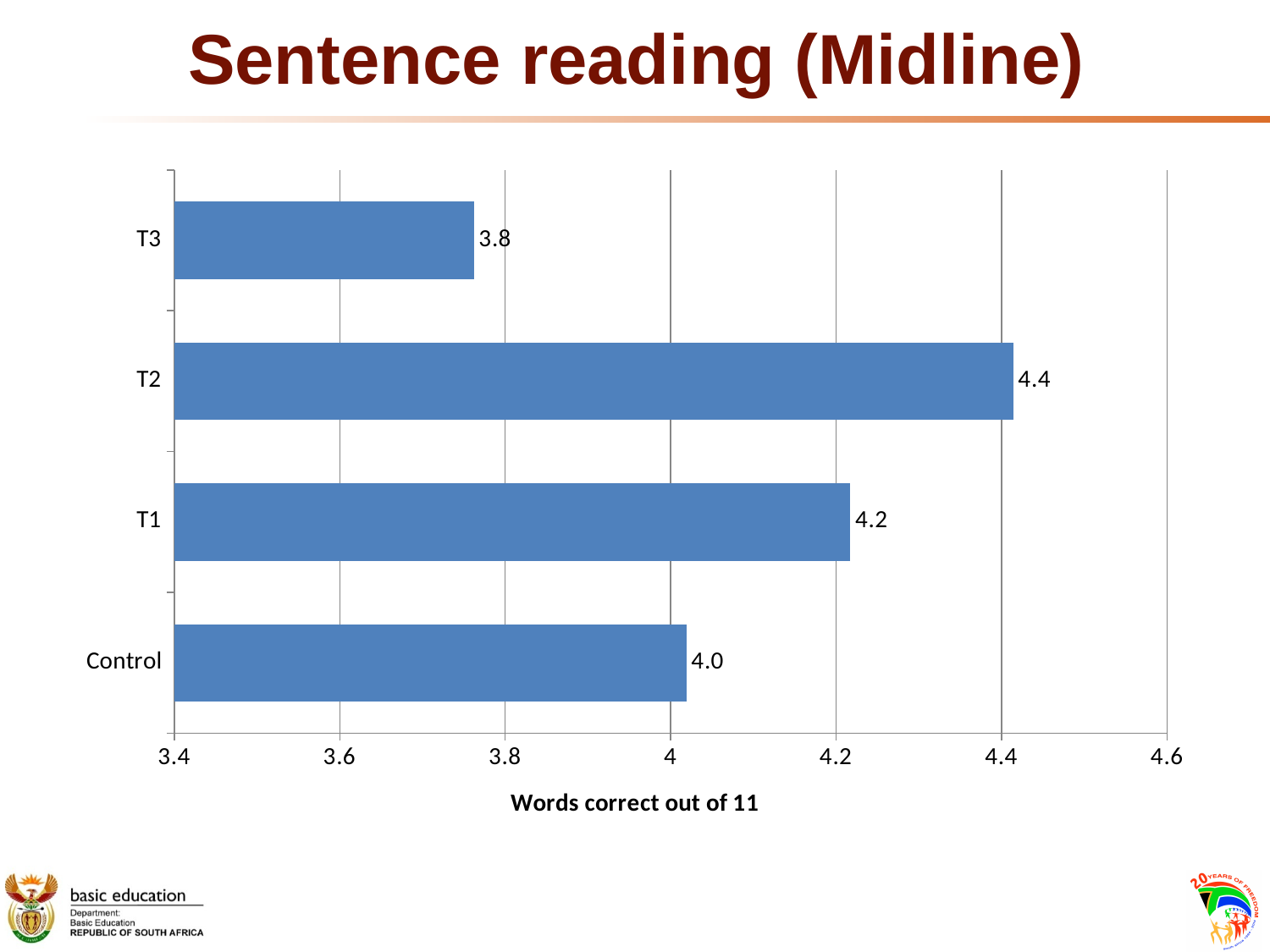
What is the value for T2? 4.4 Which category has the highest value? T2 What is the value for Control? 4.0 What kind of chart is shown on the slide? bar chart How many categories are shown in the chart? 4 Which is larger, the value for T1 or the value for Control? T1 Which category has the lowest value? T3 What is the title of the slide? Sentence reading (Midline) What is the value for T3? 3.8 Is the value for T3 greater or less than 4? less What is the label of the horizontal axis? Words correct out of 11 What is the difference between the values for T2 and T3? 0.6